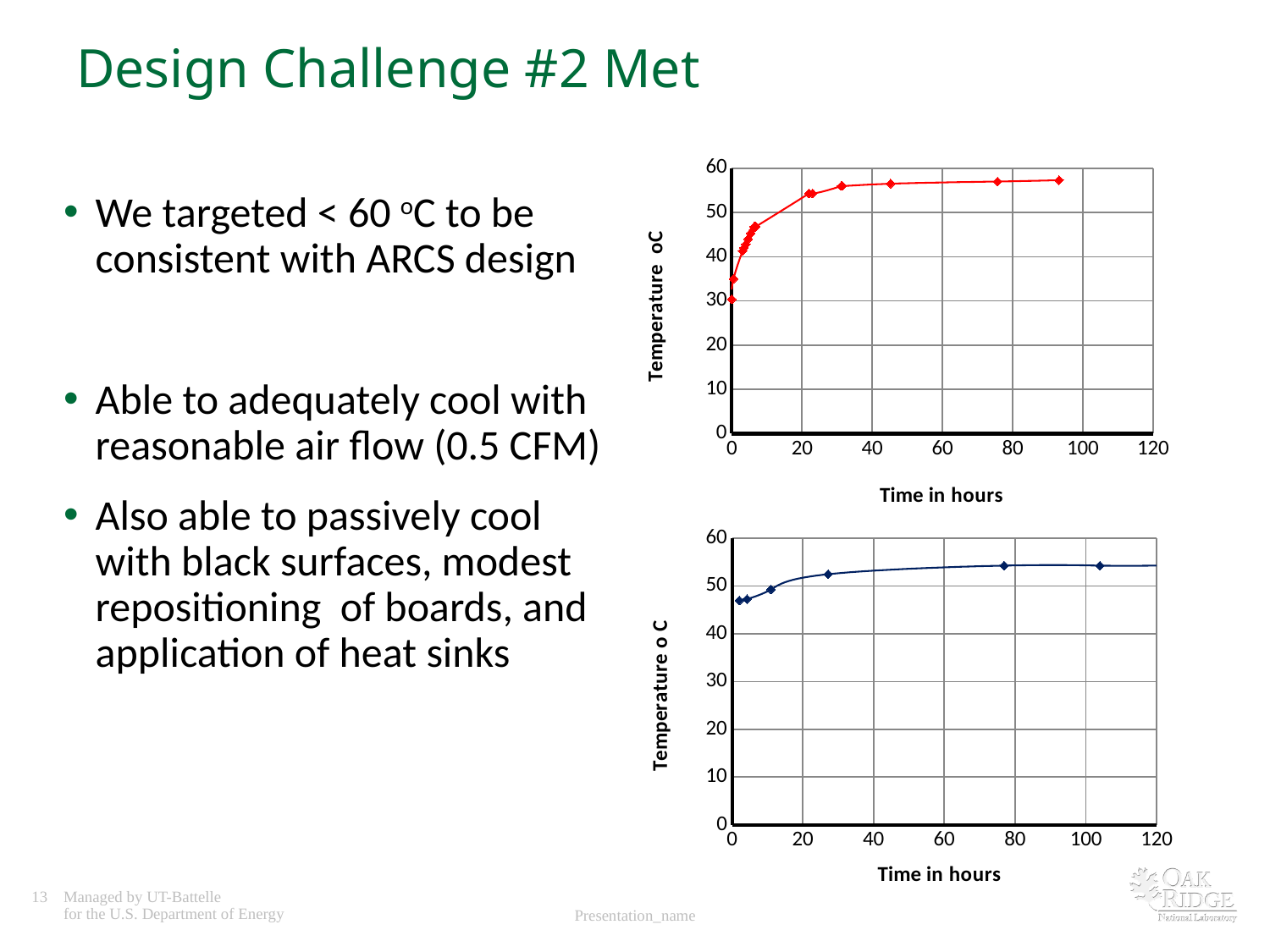
In the top chart, do the temperature values rise or fall as time in hours increases? rise What kind of chart is the bottom chart on the slide? line chart What is the x-axis title of the bottom chart? Time in hours What kind of chart is the top chart on the slide? line chart In the top chart, is the temperature at 0 hours greater or less than 40? less In the top chart, is the highest plotted temperature greater or less than 60? less In the bottom chart, is the temperature at about 100 hours greater or less than 50? greater What is the maximum value shown on the y axis of the top chart? 60 In the bottom chart, do the temperature values rise or fall as time in hours increases? rise